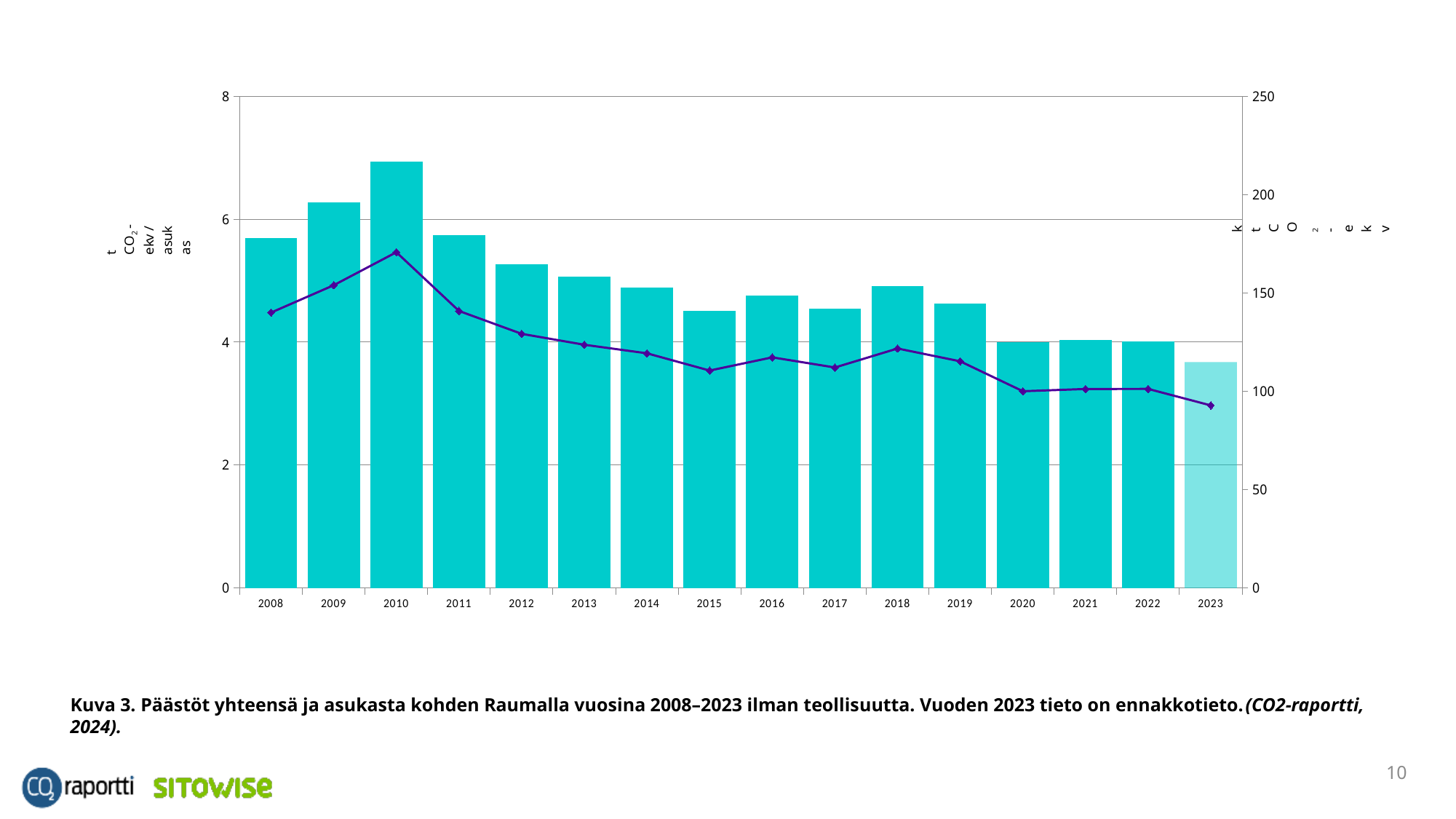
Is the line value for 2010 on the right axis greater or less than 150? greater Is the bar value for 2015 greater or less than 4? greater Which year has the taller bar, 2009 or 2012? 2009 Do the bar values generally rise or fall from 2010 to 2023? fall How many years are shown on the x axis of the chart? 16 Which year has the shortest bar in the chart? 2023 Which year has the higher line value, 2017 or 2018? 2018 Is the bar value for 2010 greater or less than 6? greater What kind of chart is shown on the slide? A bar chart combined with a line chart Which year has the tallest bar in the chart? 2010